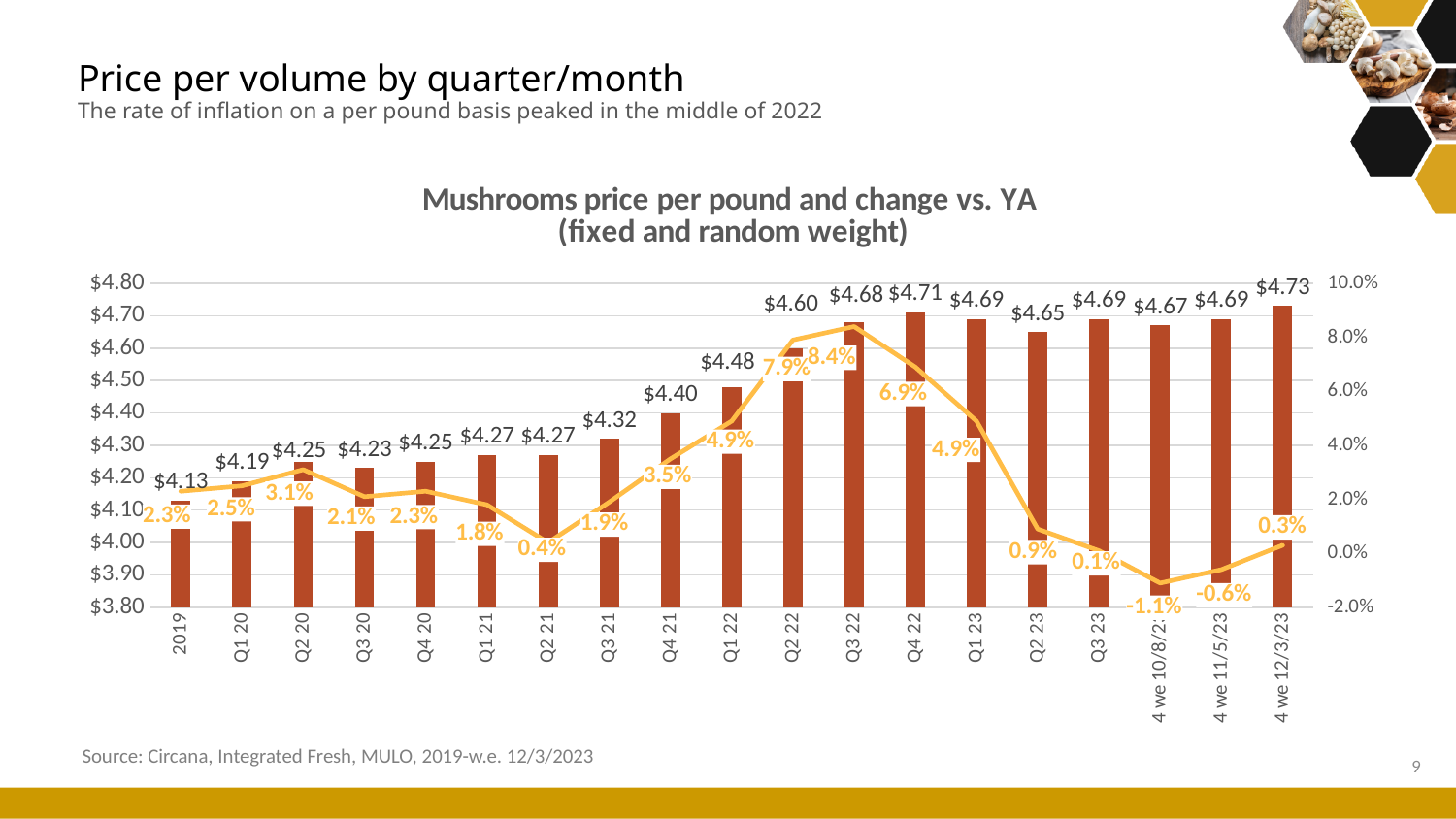
Which has the higher price per pound, Q1 22 or Q2 22? Q2 22 What is the price per pound shown for the 4 weeks ending 12/3/23? $4.73 How many periods are plotted along the x axis? 19 What kind of chart is this? Combined bar and line chart What is the mushroom price per pound shown for Q4 22? $4.71 What is the change vs. YA shown for Q2 21? 0.4% What is the difference in price per pound between the 4 weeks ending 12/3/23 and 2019? $0.60 Which period has the highest change vs. YA? Q3 22 Which period has the lowest price per pound? 2019 Which period has the highest price per pound? 4 we 12/3/23 Does the price per pound generally rise or fall from 2019 to Q4 22? Rise What is the change vs. YA shown for Q3 22? 8.4%